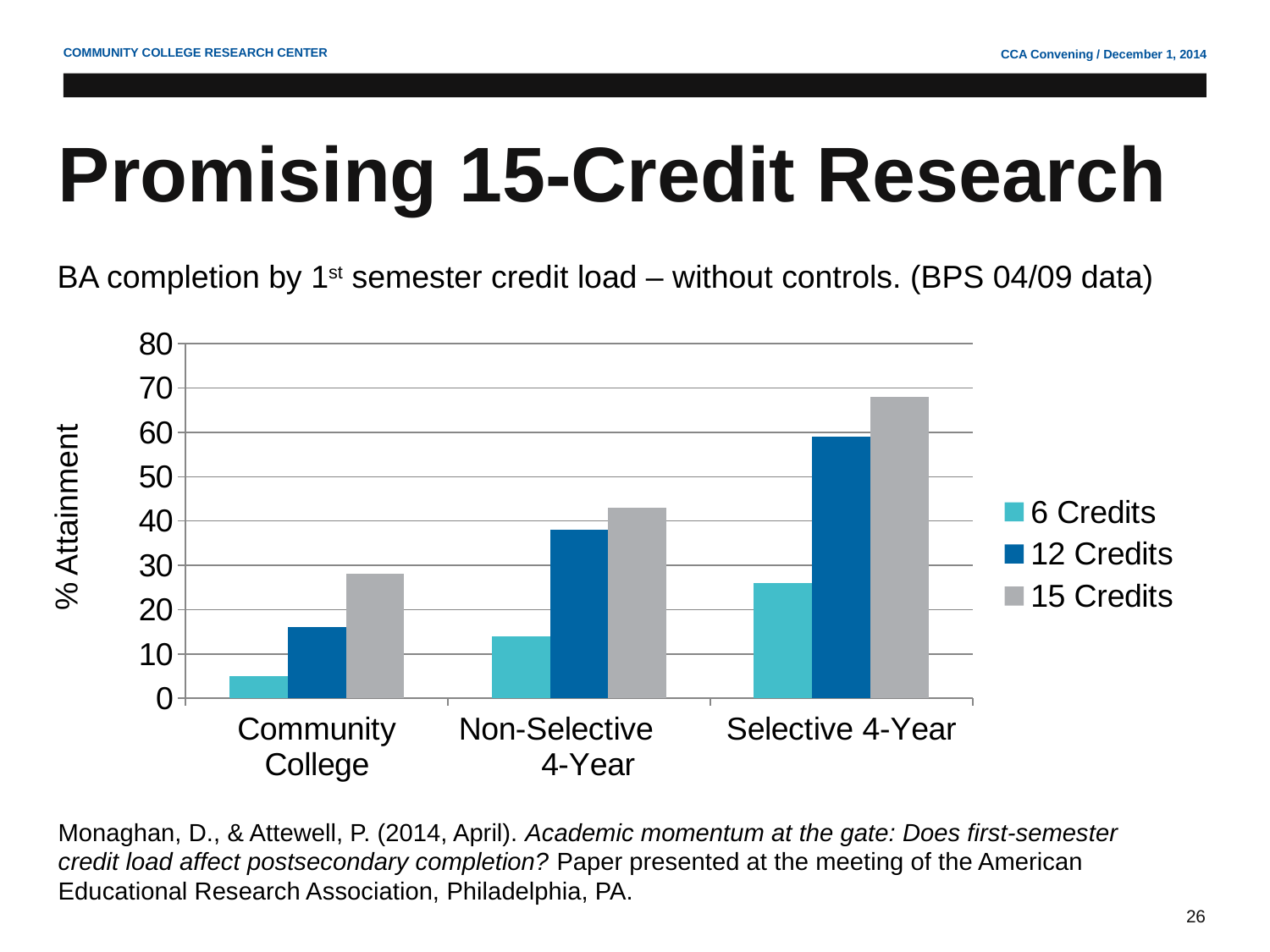
What is the label on the y axis of the chart? % Attainment Is the value for 6 Credits at Community College greater or less than 10? less Which institution type has the highest % attainment for 15 Credits? Selective 4-Year How many series does the legend list? 3 Is the value for 15 Credits at Community College greater or less than 30? less How many institution categories are shown on the x axis? 3 Is the value for 15 Credits at Selective 4-Year greater or less than 60? greater Which institution type has the lowest % attainment for 6 Credits? Community College What kind of chart is shown on the slide? bar chart Which is larger: 12 Credits at Selective 4-Year or 15 Credits at Non-Selective 4-Year? 12 Credits at Selective 4-Year Within each institution type, does % attainment rise or fall as the credit load increases from 6 to 15 credits? rise